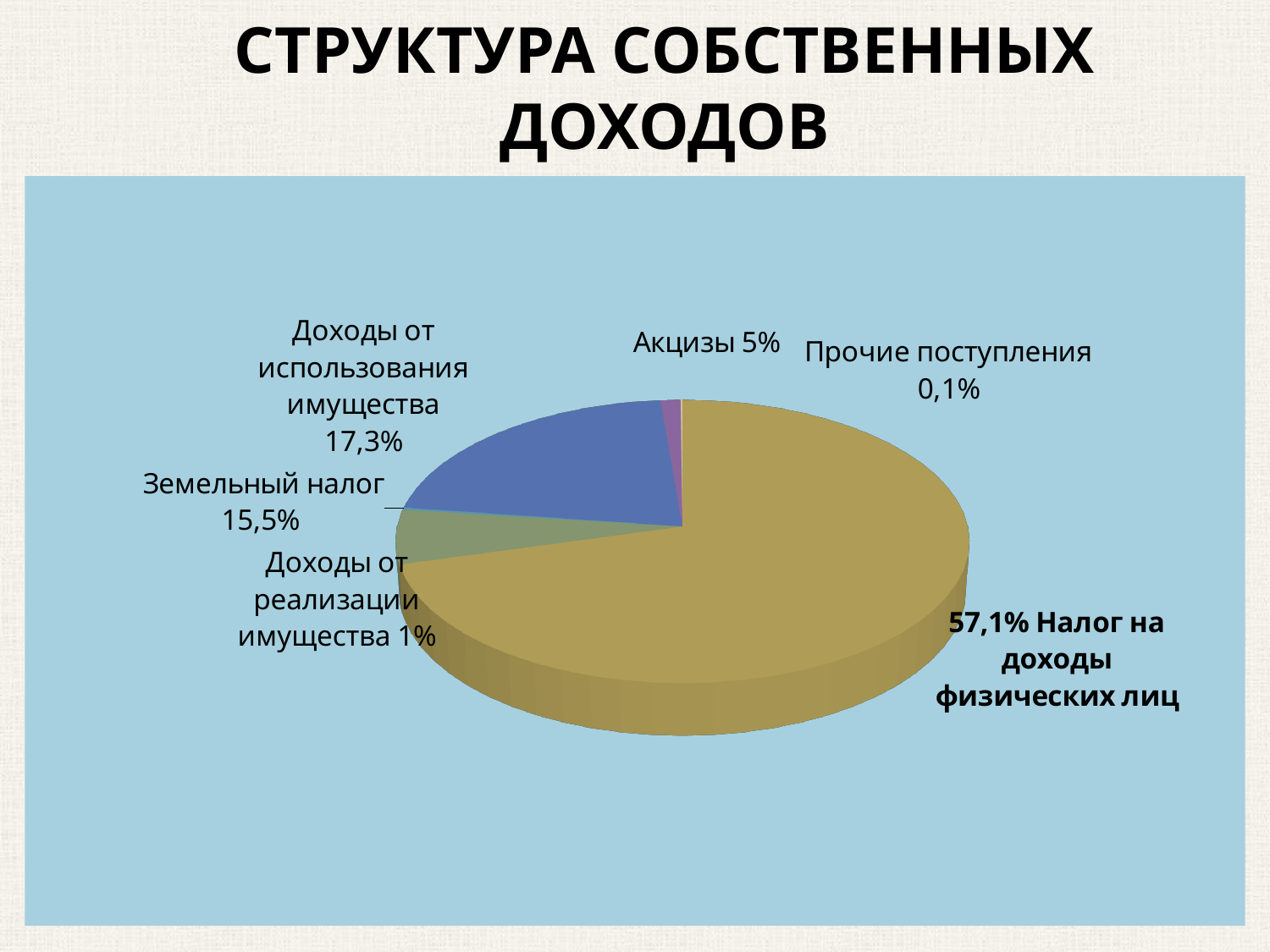
Which category has the largest share of the pie? Налог на доходы физических лиц How many categories (slices) does the pie chart have? 6 What kind of chart is shown on the slide? pie chart What share is shown for Прочие поступления? 0,1% What share is shown for Акцизы? 5% What share is shown for Земельный налог? 15,5% Which category has the smallest share of the pie? Прочие поступления What is the difference between the shares of Доходы от использования имущества and Земельный налог? 1,8% What share is shown for Доходы от использования имущества? 17,3% What share of the pie is labelled for Налог на доходы физических лиц? 57,1% What is the title of the slide's chart? СТРУКТУРА СОБСТВЕННЫХ ДОХОДОВ Which is larger: the share for Акцизы or the share for Доходы от реализации имущества? Акцизы